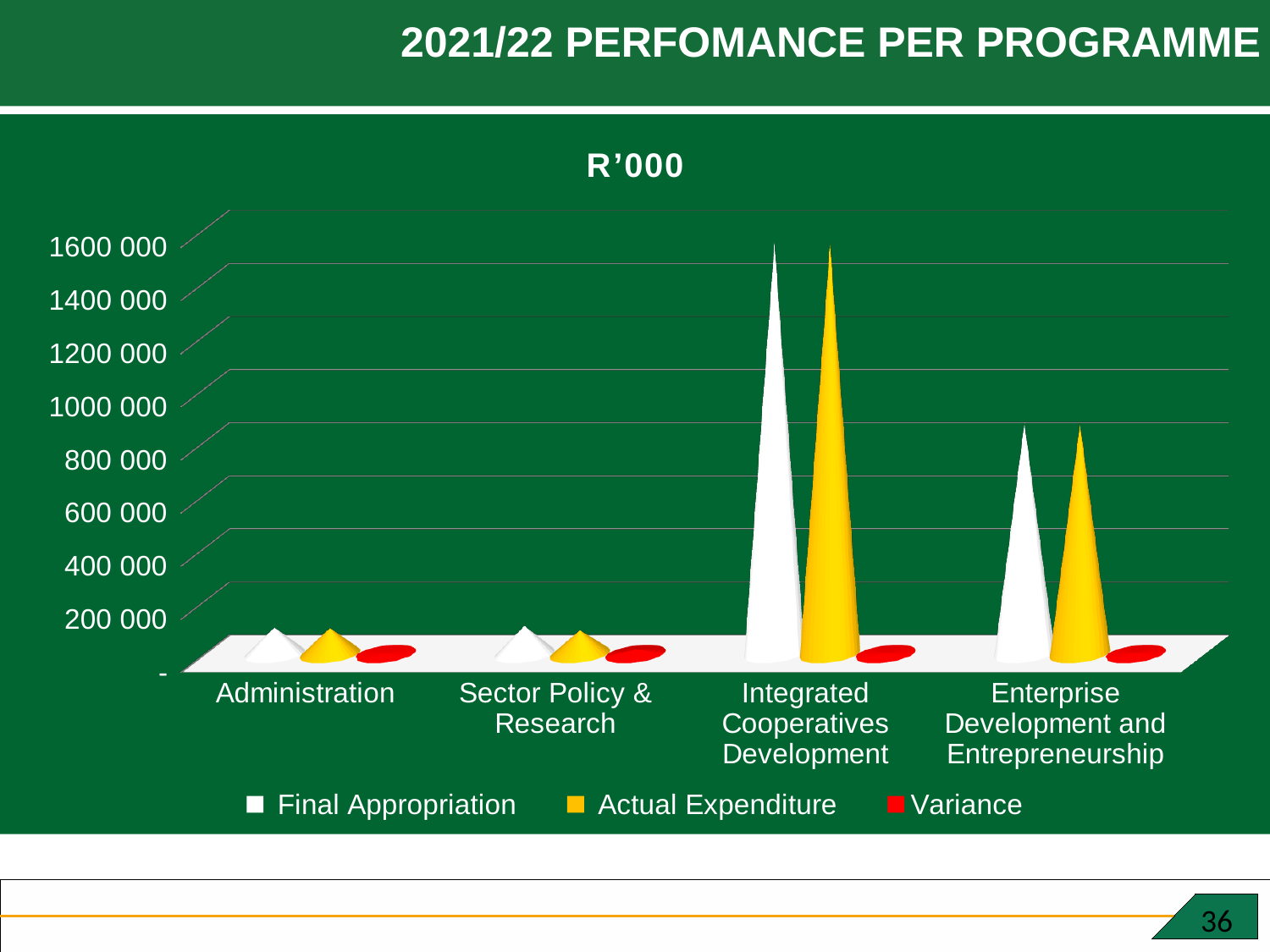
Is the Actual Expenditure for Sector Policy & Research greater or less than 400 000? less How many series does the legend list? 3 What kind of chart is shown on the slide? Bar chart Which colour represents Actual Expenditure in the legend? Yellow Which is larger: the Final Appropriation for Integrated Cooperatives Development or for Enterprise Development and Entrepreneurship? Integrated Cooperatives Development Is the Actual Expenditure for Administration greater or less than 200 000? less Is the Final Appropriation for Enterprise Development and Entrepreneurship greater or less than 1000 000? less What is the title shown above the chart? R'000 Which programme has the highest Actual Expenditure? Integrated Cooperatives Development Which programme has the highest Final Appropriation? Integrated Cooperatives Development How many programmes (categories) are shown on the x axis? 4